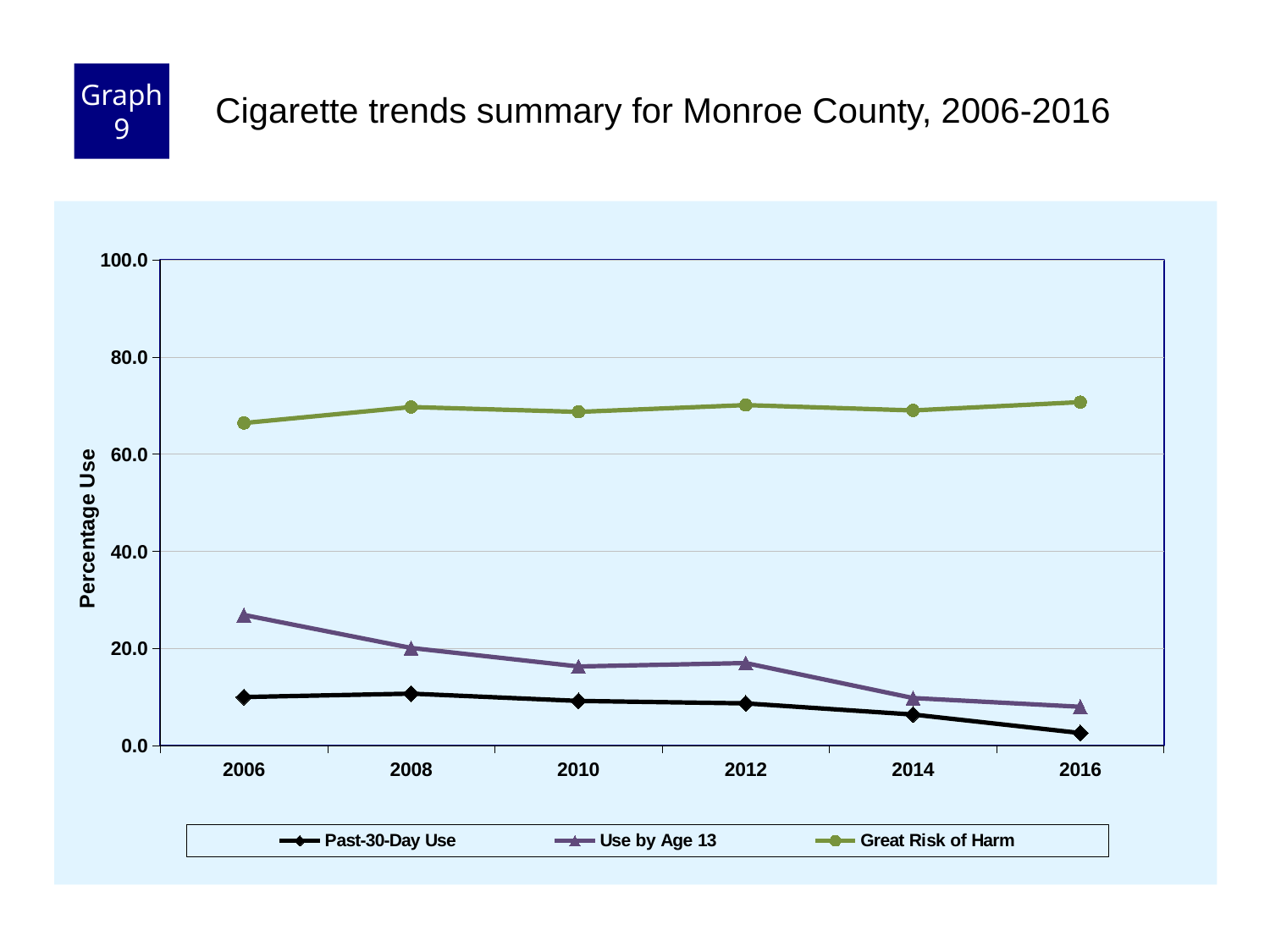
How many series does the legend list? 3 Is the value for Use by Age 13 in 2016 greater or less than 20? less In which year is Use by Age 13 highest? 2006 Does Use by Age 13 rise or fall from 2006 to 2016? fall How many years are plotted along the x axis? 6 Is the value for Past-30-Day Use in 2016 greater or less than 20? less Is the value for Great Risk of Harm in 2006 greater or less than 60? greater What is the title of the chart? Cigarette trends summary for Monroe County, 2006-2016 What is the label on the vertical axis? Percentage Use What kind of chart is shown on the slide? line chart In which year is Past-30-Day Use lowest? 2016